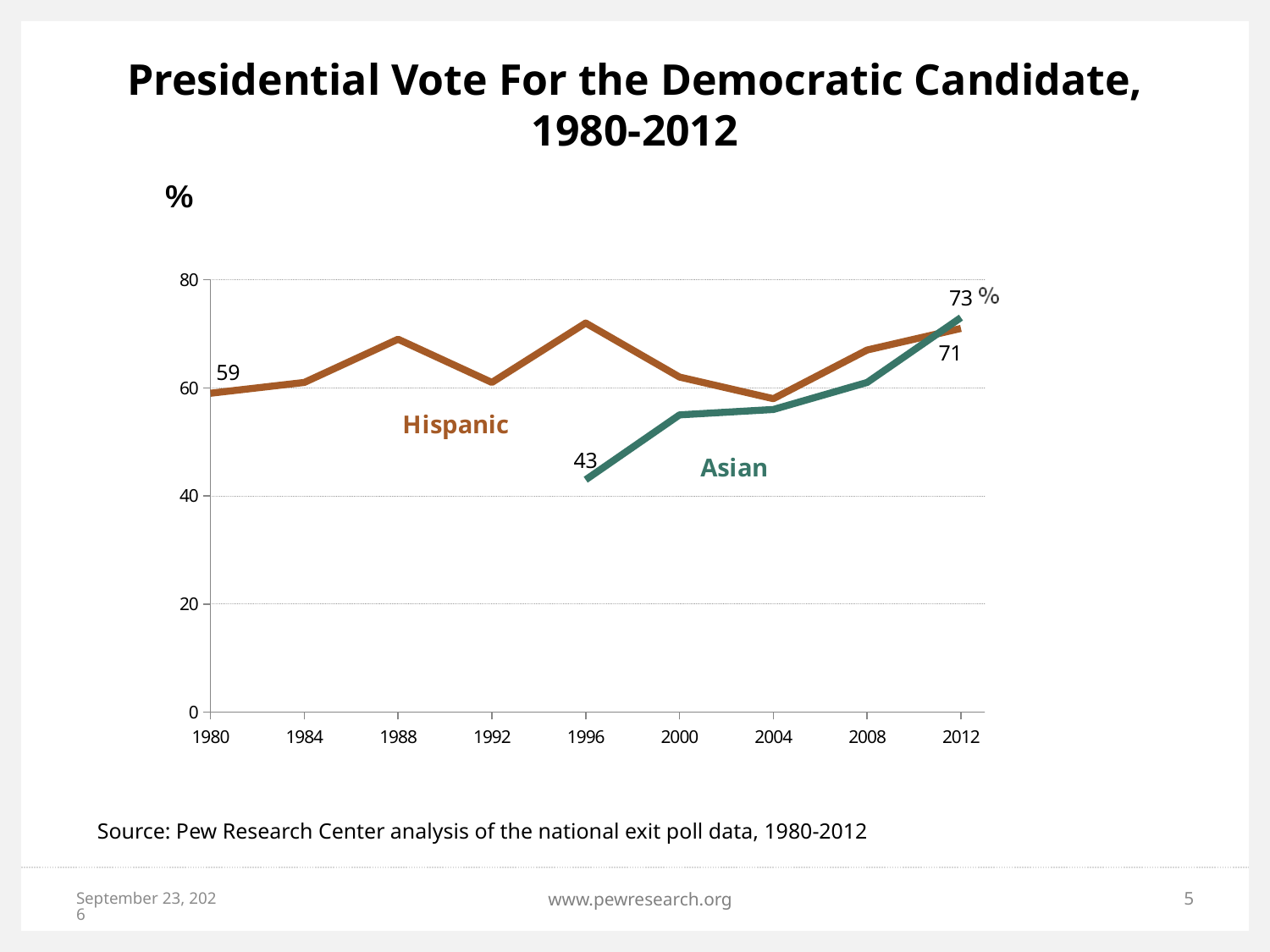
How many election years are shown on the x axis? 9 What is the Asian value for 1996? 43 What kind of chart is shown on the slide? line chart By how much did the Hispanic value increase from 1980 to 2012? 12 By how much did the Asian value increase from 1996 to 2012? 30 What is the Hispanic value for 1980? 59 What is the Hispanic value for 2012? 71 Is the Asian value for 2004 greater or less than 60? less In 2012, which group had the higher value, Hispanic or Asian? Asian What is the Asian value for 2012? 73 % How many series are plotted on the chart? 2 Is the Hispanic value for 1996 greater or less than 60? greater